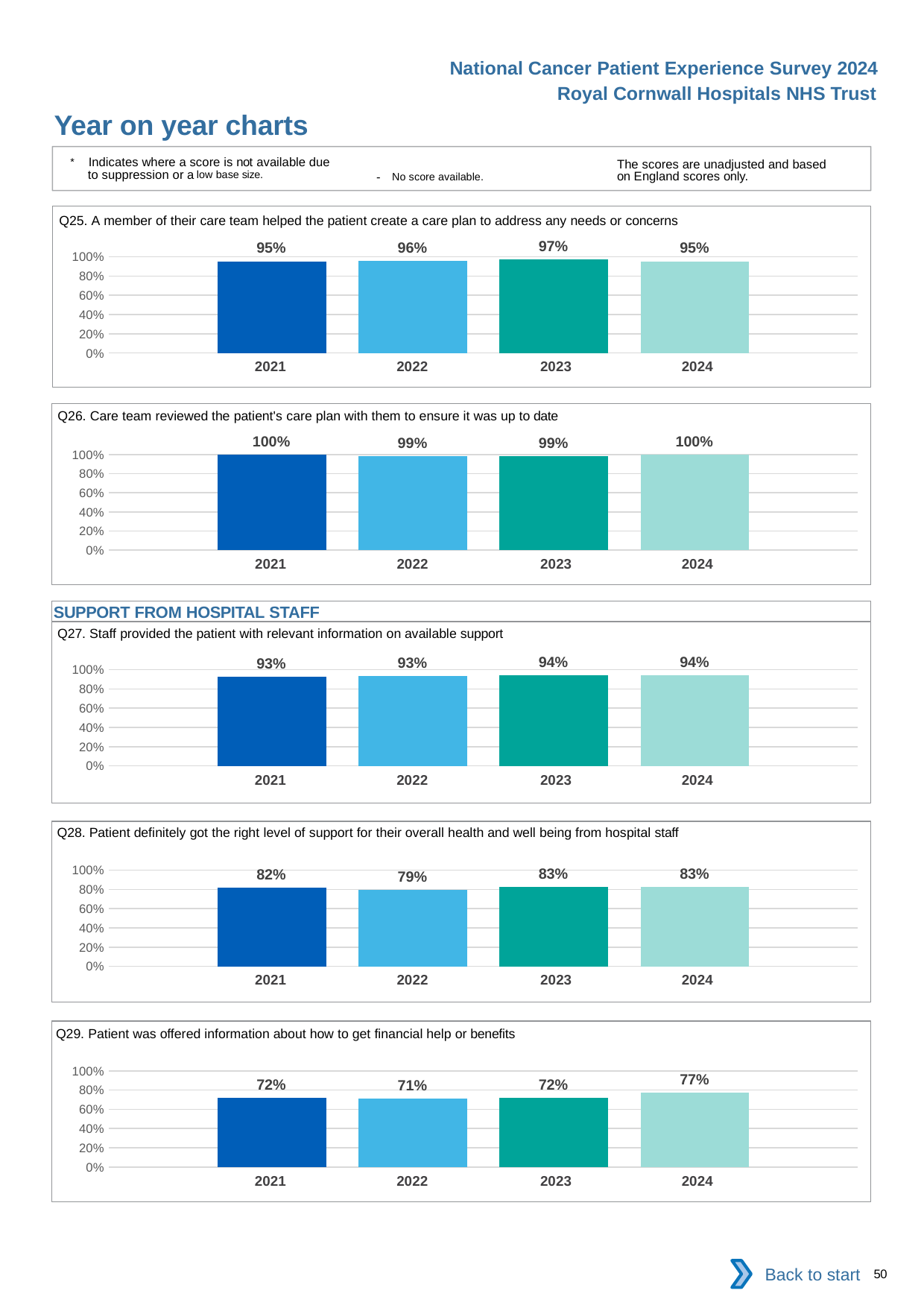
What kind of chart is the Q27 chart? bar chart How many years are shown on the x axis of the Q25 chart? 4 What is the section heading shown above the Q27 chart? SUPPORT FROM HOSPITAL STAFF In the Q26 chart, which year has the lowest value? 2022 and 2023 In the Q28 chart, which year has the lowest value? 2022 In the Q26 chart, what is the value for 2021? 100% In the Q27 chart, what is the difference between the 2024 value and the 2021 value? 1% In the Q29 chart, which year has the highest value? 2024 In the Q28 chart, is the value for 2021 larger or smaller than the value for 2022? larger In the Q25 chart, what is the value for 2023? 97% In the Q29 chart, is the value for 2021 greater or less than 80%? less In the Q29 chart, what is the difference between the 2024 value and the 2022 value? 6%